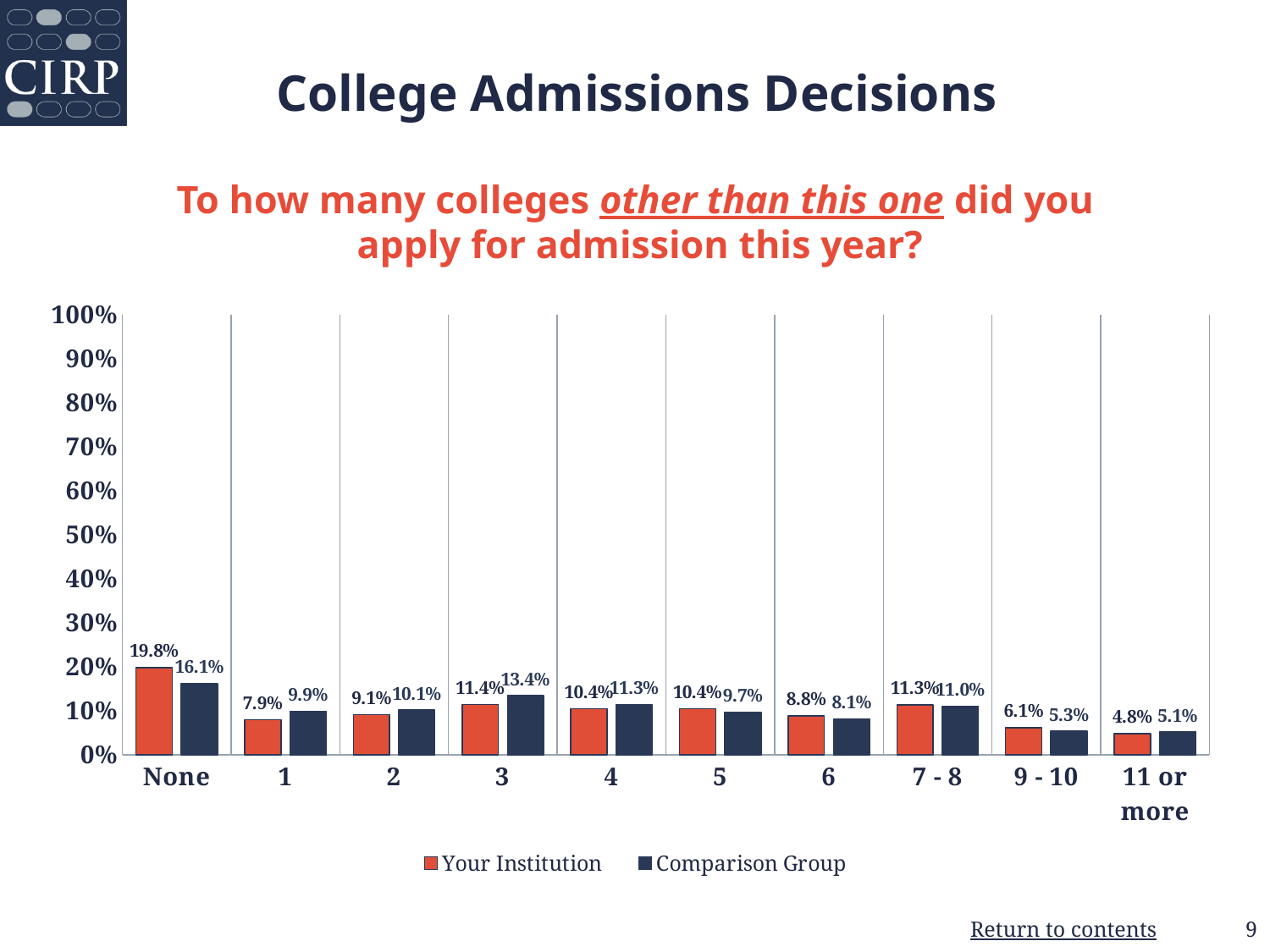
What is the difference between Your Institution and Comparison Group in the 1 category? 2.0% What is the value for Your Institution in the 9 - 10 category? 6.1% Which category has the lowest value for Your Institution? 11 or more How many series does the legend list? 2 What is the difference between Your Institution and Comparison Group in the None category? 3.7% What kind of chart is shown on the slide? bar chart What is the value for Comparison Group in the 3 category? 13.4% Is the value for Your Institution in the None category greater or less than 10%? greater What is the value for Your Institution in the None category? 19.8% How many categories are shown on the x axis? 10 Which is larger in the 5 category, Your Institution or Comparison Group? Your Institution Which category has the highest value for Comparison Group? None